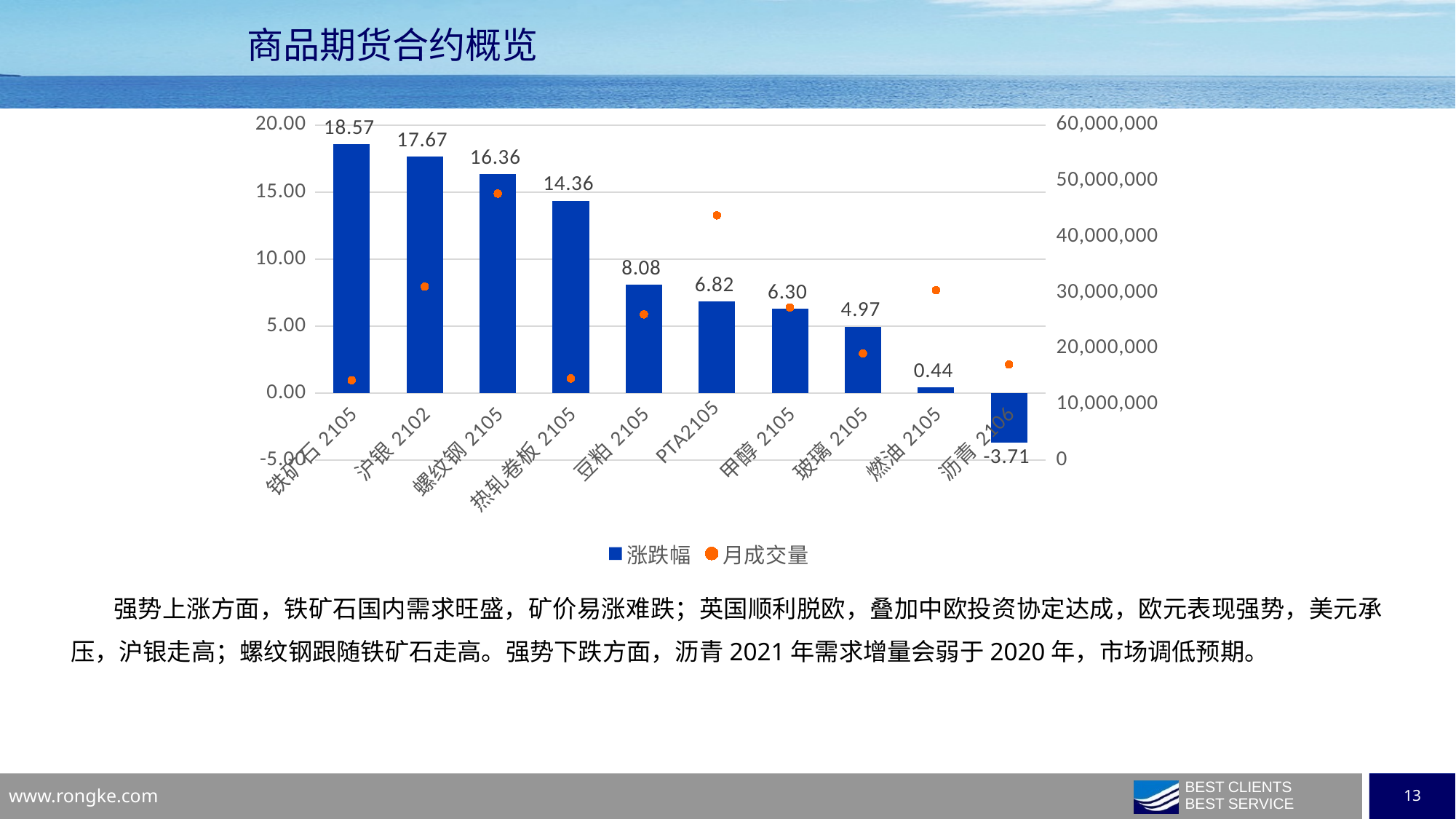
Is the 月成交量 value for PTA2105 greater or less than 40,000,000? greater What is the 涨跌幅 value for 沥青 2106? -3.71 How many contracts are shown on the x axis? 10 Do the 涨跌幅 bar values rise or fall from left to right along the x axis? fall Which contract has the lowest 涨跌幅? 沥青 2106 What is the 涨跌幅 value for 豆粕 2105? 8.08 What is the 涨跌幅 value for 铁矿石 2105? 18.57 Is the 月成交量 value for 铁矿石 2105 greater or less than 20,000,000? less Which has a larger 涨跌幅, 甲醇 2105 or 玻璃 2105? 甲醇 2105 What is the difference in 涨跌幅 between 铁矿石 2105 and 沪银 2102? 0.90 How many series does the legend list? 2 Which contract has the highest 涨跌幅? 铁矿石 2105